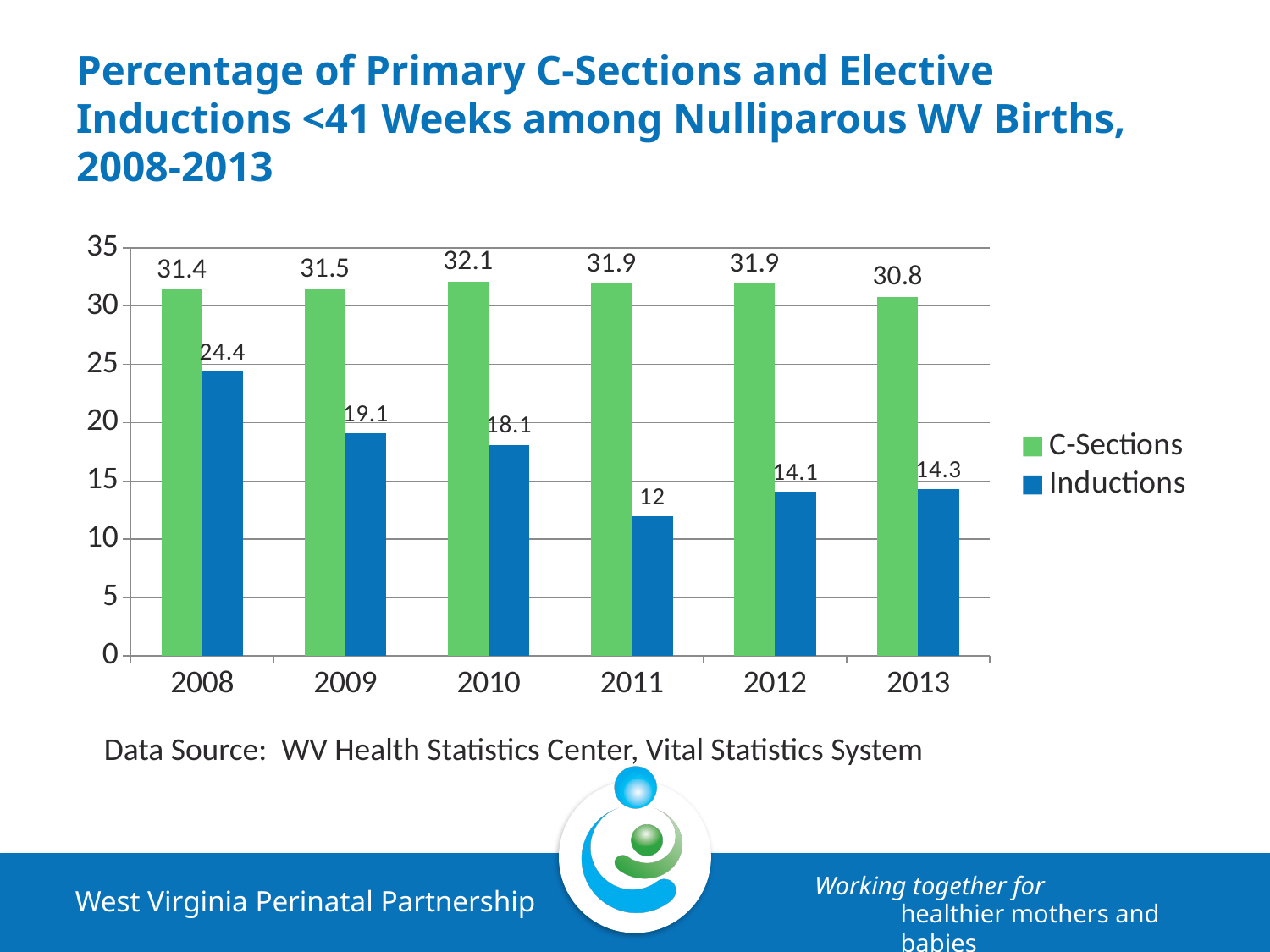
Which year has the lowest C-Sections value? 2013 What kind of chart is shown? bar chart What is the Inductions value for 2011? 12 Which colour represents Inductions in the legend? blue How many years are shown on the x axis? 6 Which is larger, the Inductions value for 2009 or for 2012? 2009 Which year has the highest Inductions value? 2008 Is the Inductions value for 2010 greater or less than 20? less What is the difference between the C-Sections and Inductions values in 2013? 16.5 What is the Inductions value for 2008? 24.4 How many series does the legend list? 2 What is the C-Sections value for 2010? 32.1